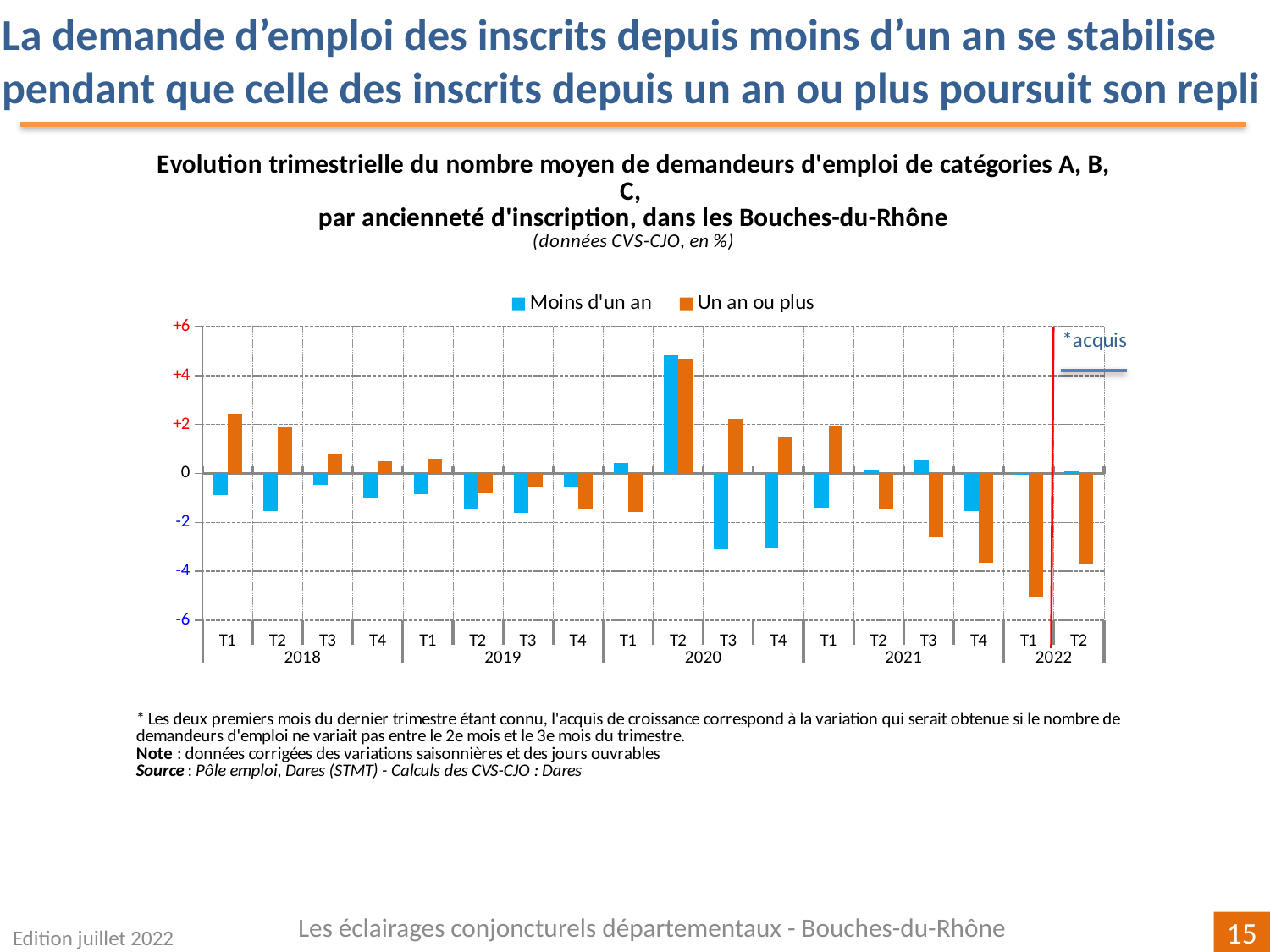
In T1 2018, which series has the larger value, 'Moins d'un an' or 'Un an ou plus'? Un an ou plus What are the two series named in the legend? Moins d'un an; Un an ou plus Which colour represents the series 'Un an ou plus'? orange What kind of chart is shown on the slide? bar chart In which quarter is the value for 'Un an ou plus' the lowest? T1 2022 In which quarter is the value for 'Moins d'un an' the highest? T2 2020 Is the value for 'Un an ou plus' in T1 2022 greater or less than -4? less Is the value for 'Un an ou plus' in T4 2021 greater or less than -2? less Is the value for 'Moins d'un an' in T3 2020 greater or less than -2? less How many quarters are plotted along the x axis? 18 How many series does the legend list? 2